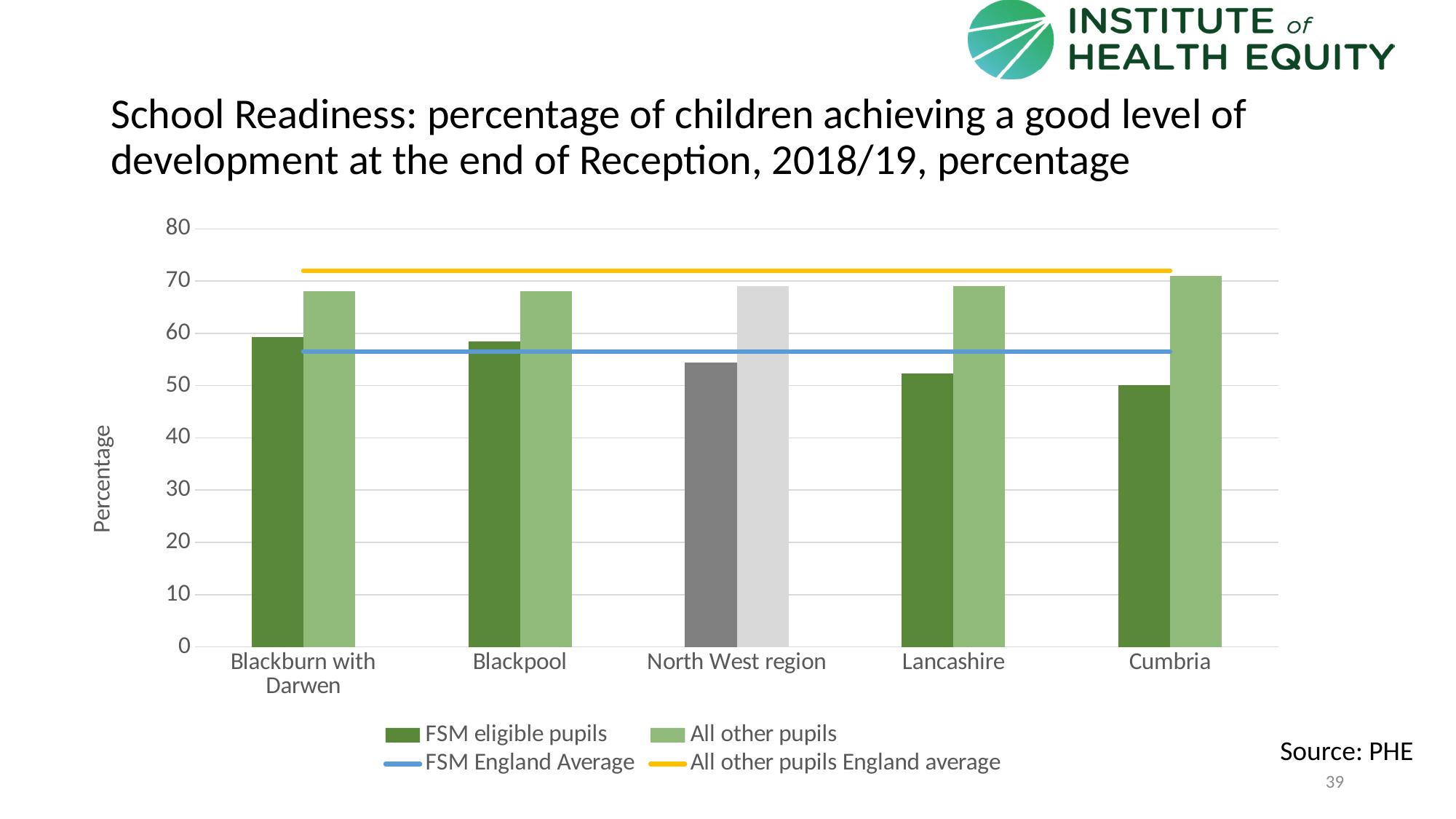
How many series does the legend list? 4 Is the value for FSM eligible pupils in Cumbria greater or less than 60? less Do the values for FSM eligible pupils rise or fall moving from left to right across the x axis? fall What colour is the line representing the All other pupils England average? yellow Which is larger in Lancashire: the value for FSM eligible pupils or for All other pupils? All other pupils How many areas (categories) are shown on the x axis? 5 What kind of chart is shown on the slide? bar chart Which area has the lowest value for FSM eligible pupils? Cumbria Which area has the highest value for All other pupils? Cumbria Is the value for FSM eligible pupils in Blackburn with Darwen greater or less than 50? greater Is the value for FSM eligible pupils in the North West region greater or less than 60? less